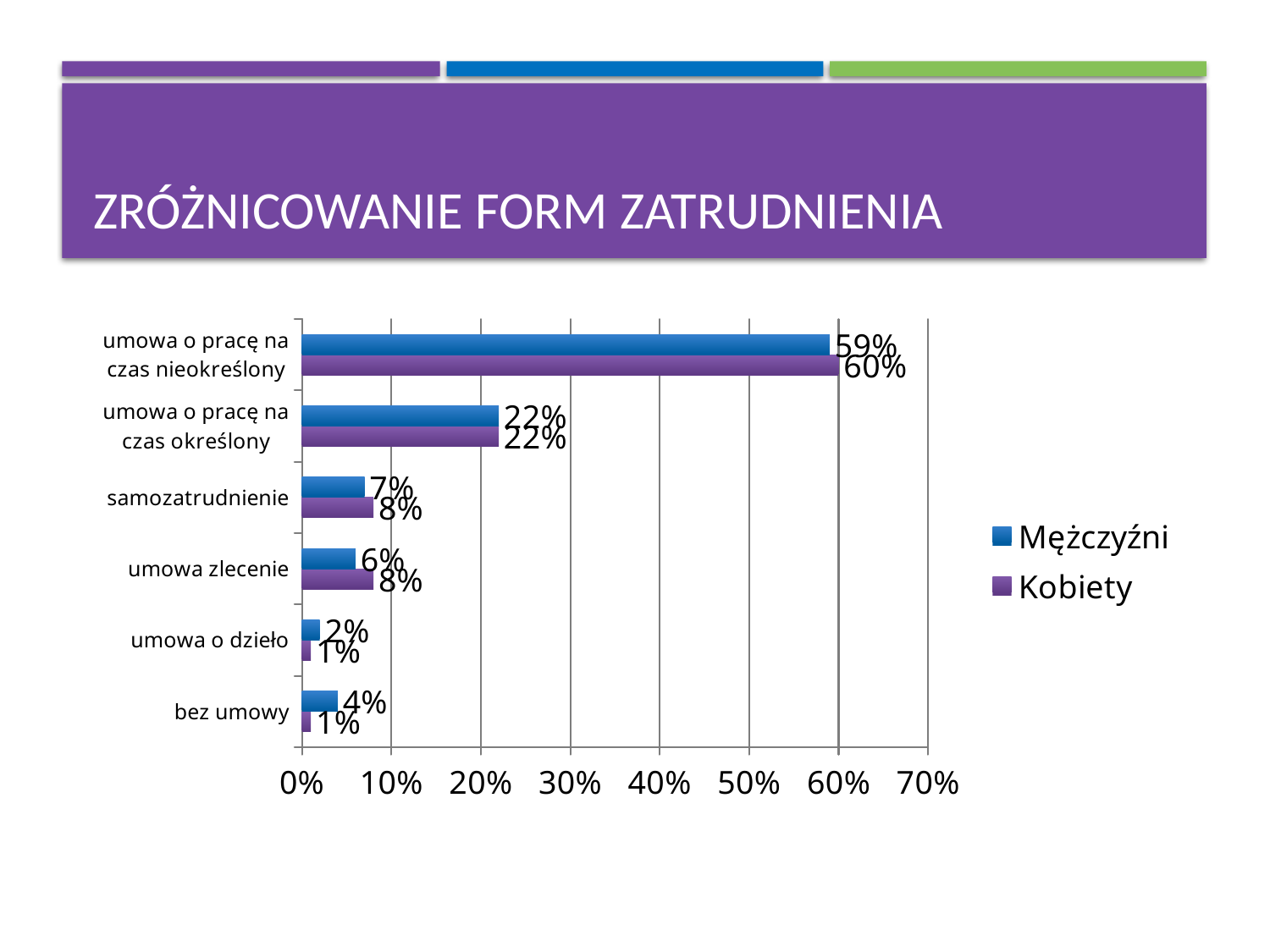
What is the value for Mężczyźni for 'umowa o pracę na czas nieokreślony'? 59% What kind of chart is shown on the slide? bar chart What is the value for Mężczyźni for 'bez umowy'? 4% For 'umowa zlecenie', which series has the larger value, Mężczyźni or Kobiety? Kobiety Which category has the highest value for Kobiety? umowa o pracę na czas nieokreślony What is the difference between the Kobiety and Mężczyźni values for 'bez umowy'? 3% How many employment categories are shown on the chart? 6 Which category has the lowest value for Mężczyźni? umowa o dzieło How many series does the legend list? 2 Is the Mężczyźni value for 'umowa o pracę na czas określony' greater or less than 30%? less What is the value for Kobiety for 'umowa o pracę na czas nieokreślony'? 60% What is the value for Kobiety for 'samozatrudnienie'? 8%